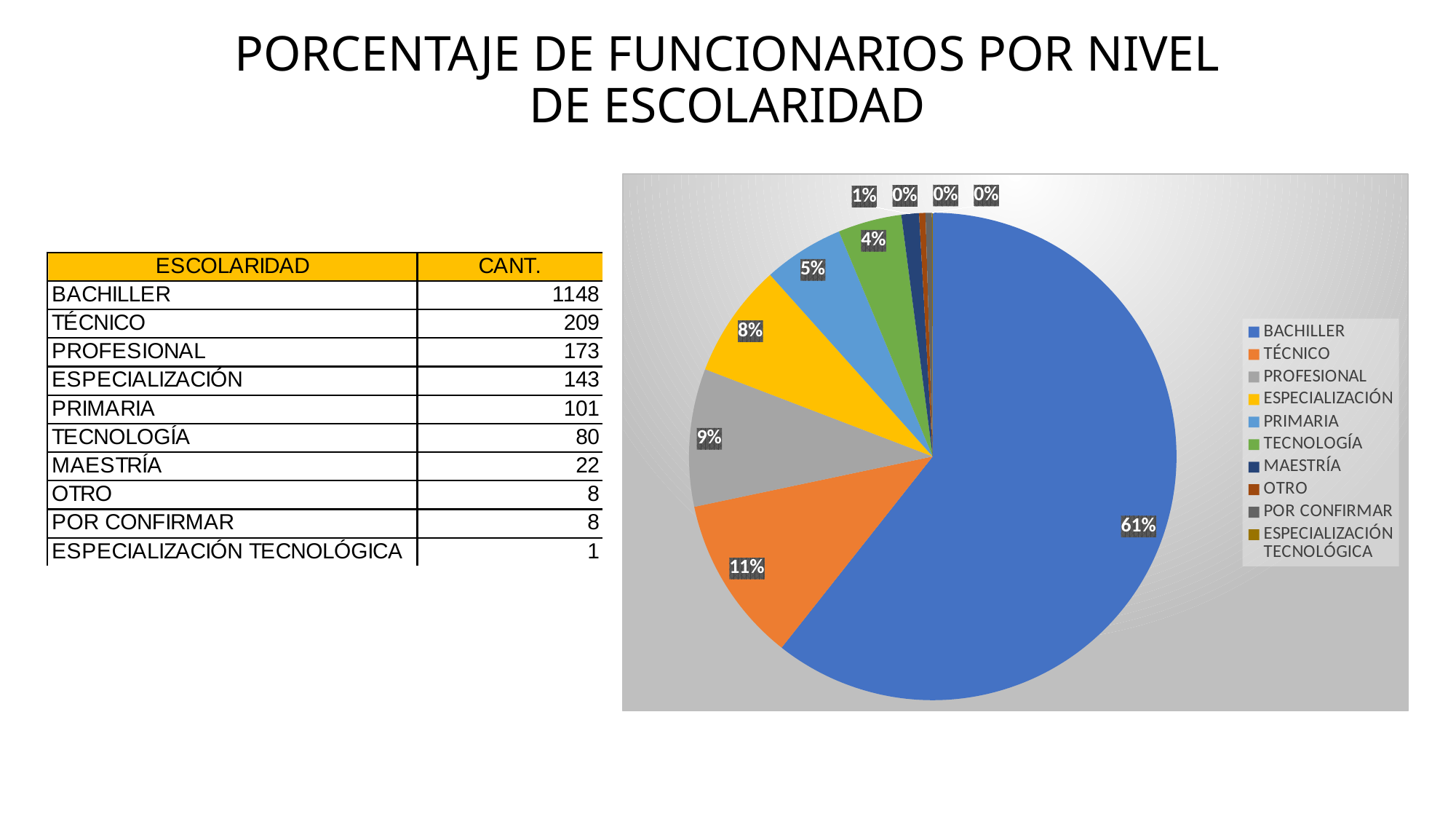
What share of the pie does PRIMARIA represent? 5% What type of chart is shown on the slide? Pie chart What share of the pie does PROFESIONAL represent? 9% What is the difference in percentage points between the BACHILLER slice and the TÉCNICO slice? 50 What share of the pie does MAESTRÍA represent? 1% Which category has the largest slice of the pie? BACHILLER How many categories does the legend of the pie chart list? 10 Which slice is larger, TÉCNICO or PRIMARIA? TÉCNICO